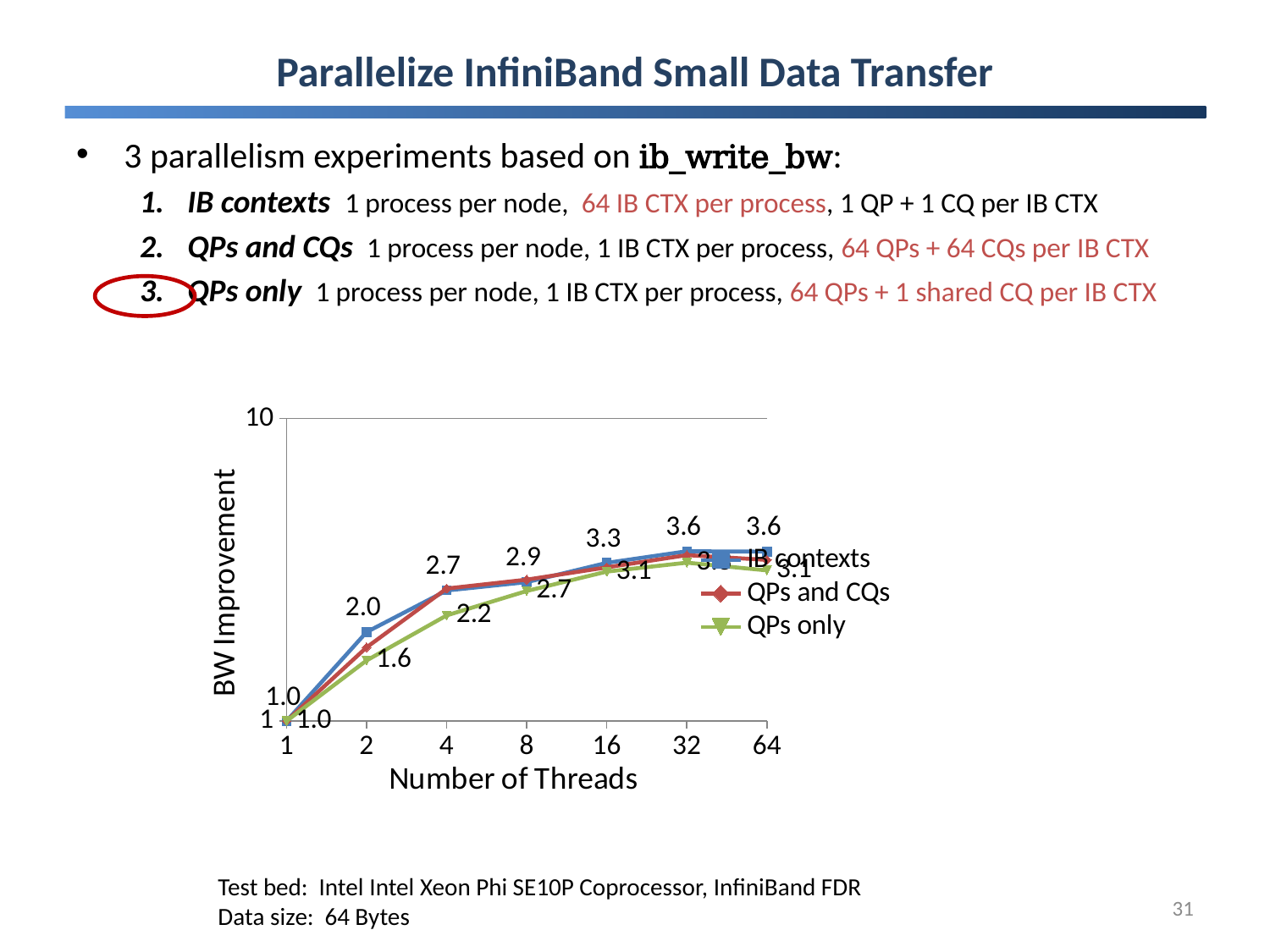
What is the title of the chart's x axis? Number of Threads What is the BW Improvement for QPs only at 4 threads? 2.2 At which number of threads is the IB contexts series lowest? 1 How many thread counts are plotted along the x axis? 7 How many series does the chart's legend list? 3 What kind of chart is shown on the slide? line chart What is the BW Improvement for IB contexts at 16 threads? 3.3 What is the BW Improvement for QPs only at 64 threads? 3.1 At 4 threads, which series has the higher BW Improvement: IB contexts or QPs only? IB contexts What is the BW Improvement for IB contexts at 32 threads? 3.6 What is the difference between the IB contexts value and the QPs only value at 2 threads? 0.4 Does the IB contexts series rise or fall from 1 to 32 threads? rise